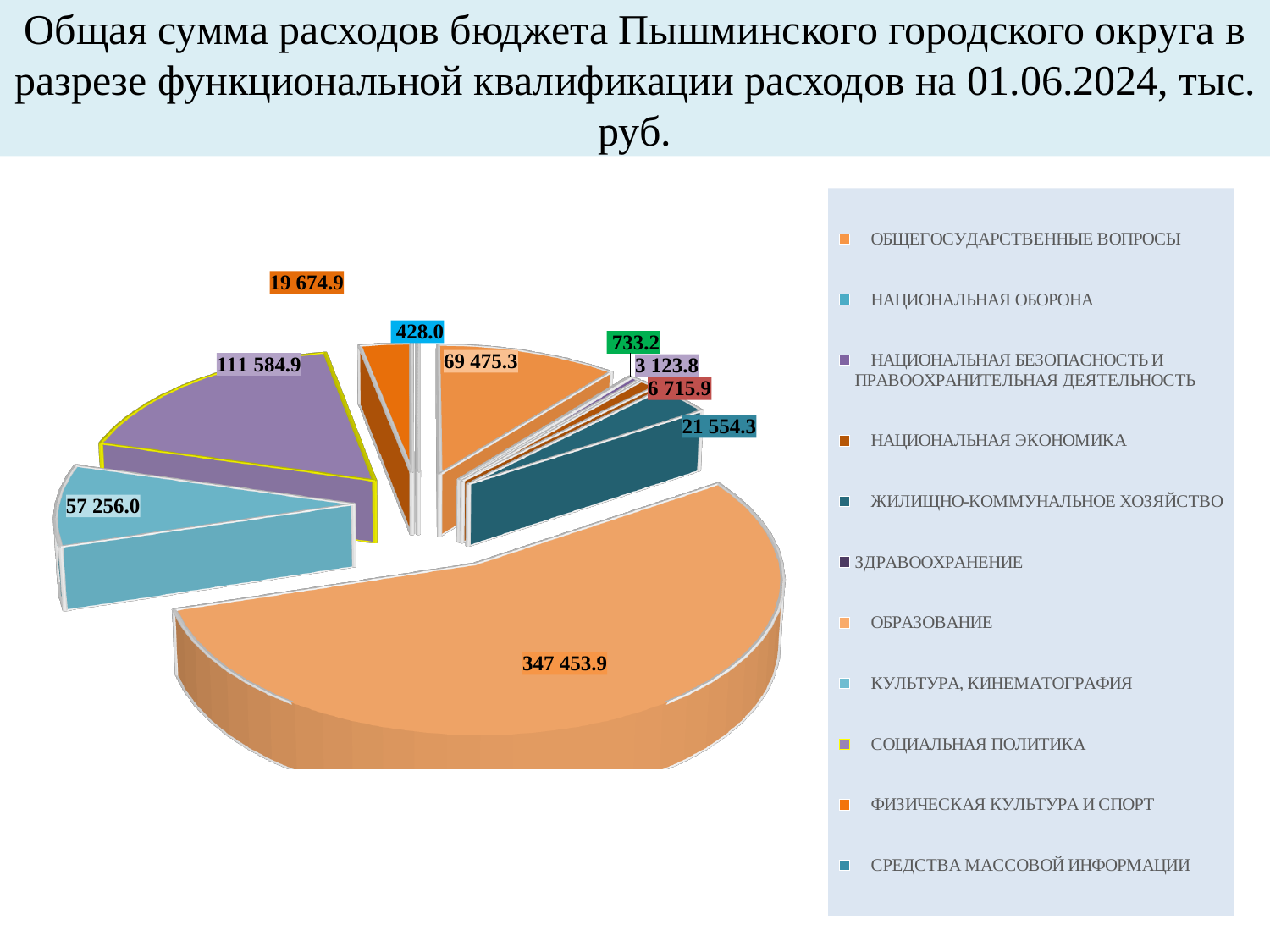
Which category has the largest slice of the pie? ОБРАЗОВАНИЕ What is the value for ОБЩЕГОСУДАРСТВЕННЫЕ ВОПРОСЫ? 69 475.3 What kind of chart is shown on the slide? pie chart What is the smallest value labelled on the pie chart? 428.0 What is the difference between the values for СОЦИАЛЬНАЯ ПОЛИТИКА and КУЛЬТУРА, КИНЕМАТОГРАФИЯ? 54 328.9 What is the value for ОБРАЗОВАНИЕ? 347 453.9 How many categories does the legend list? 11 What is the value for КУЛЬТУРА, КИНЕМАТОГРАФИЯ? 57 256.0 What is the value for ЖИЛИЩНО-КОММУНАЛЬНОЕ ХОЗЯЙСТВО? 21 554.3 What unit of measurement is stated in the chart title? тыс. руб. What is the value for СОЦИАЛЬНАЯ ПОЛИТИКА? 111 584.9 Which is larger, the value for ОБЩЕГОСУДАРСТВЕННЫЕ ВОПРОСЫ or the value for ЖИЛИЩНО-КОММУНАЛЬНОЕ ХОЗЯЙСТВО? ОБЩЕГОСУДАРСТВЕННЫЕ ВОПРОСЫ